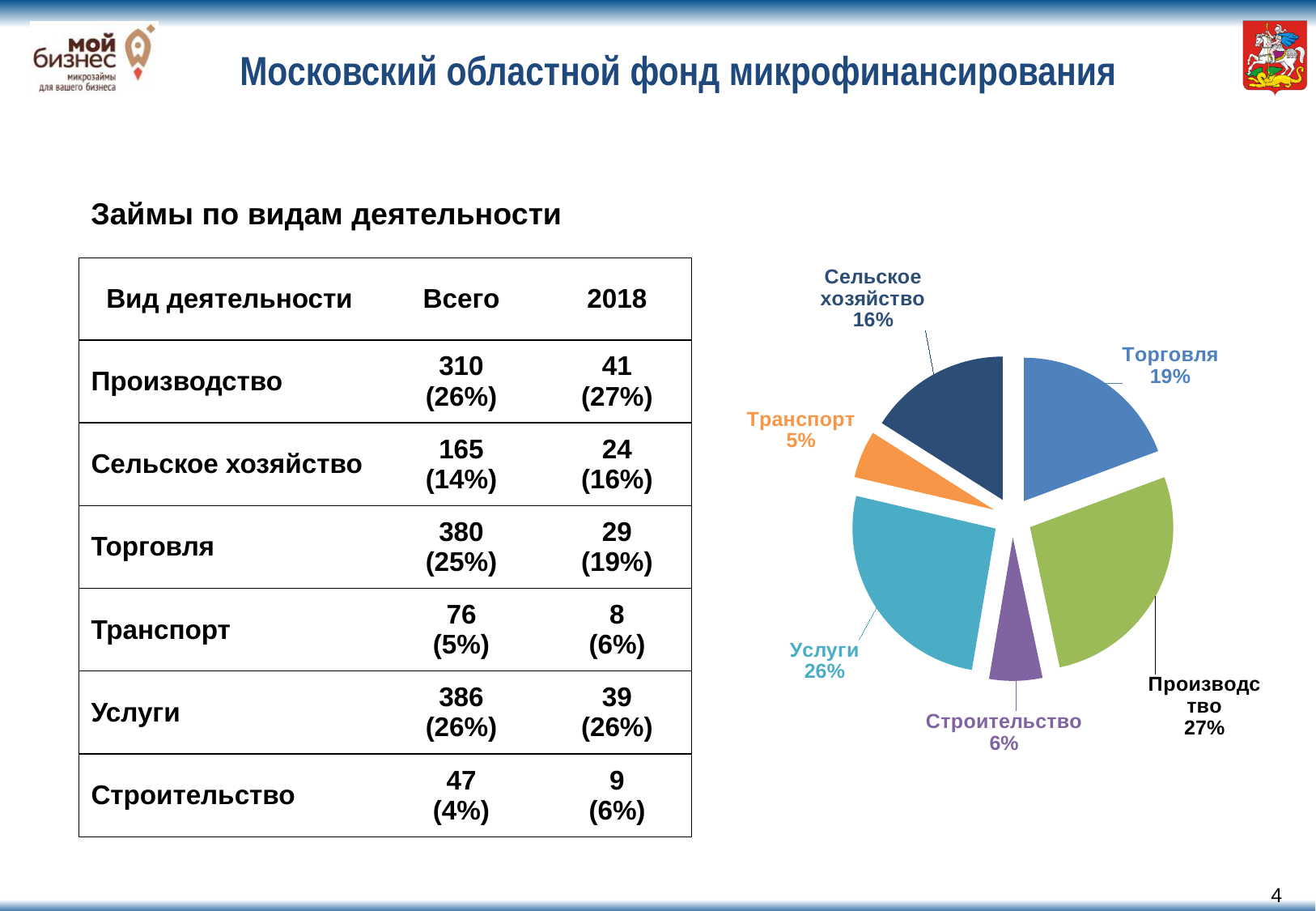
In the pie chart, what share does Транспорт have? 5% What colour is the Транспорт slice in the pie chart? orange Which slice of the pie chart is the smallest? Транспорт In the pie chart, what share does Торговля have? 19% In the pie chart, what share does Сельское хозяйство have? 16% In the pie chart, what is the difference in percentage points between Производство and Услуги? 1 In the pie chart, what share does Услуги have? 26% In the pie chart, what share does Строительство have? 6% How many slices does the pie chart have? 6 In the pie chart, which is larger: Торговля or Сельское хозяйство? Торговля What kind of chart is shown on the slide? pie chart Which slice of the pie chart is the largest? Производство